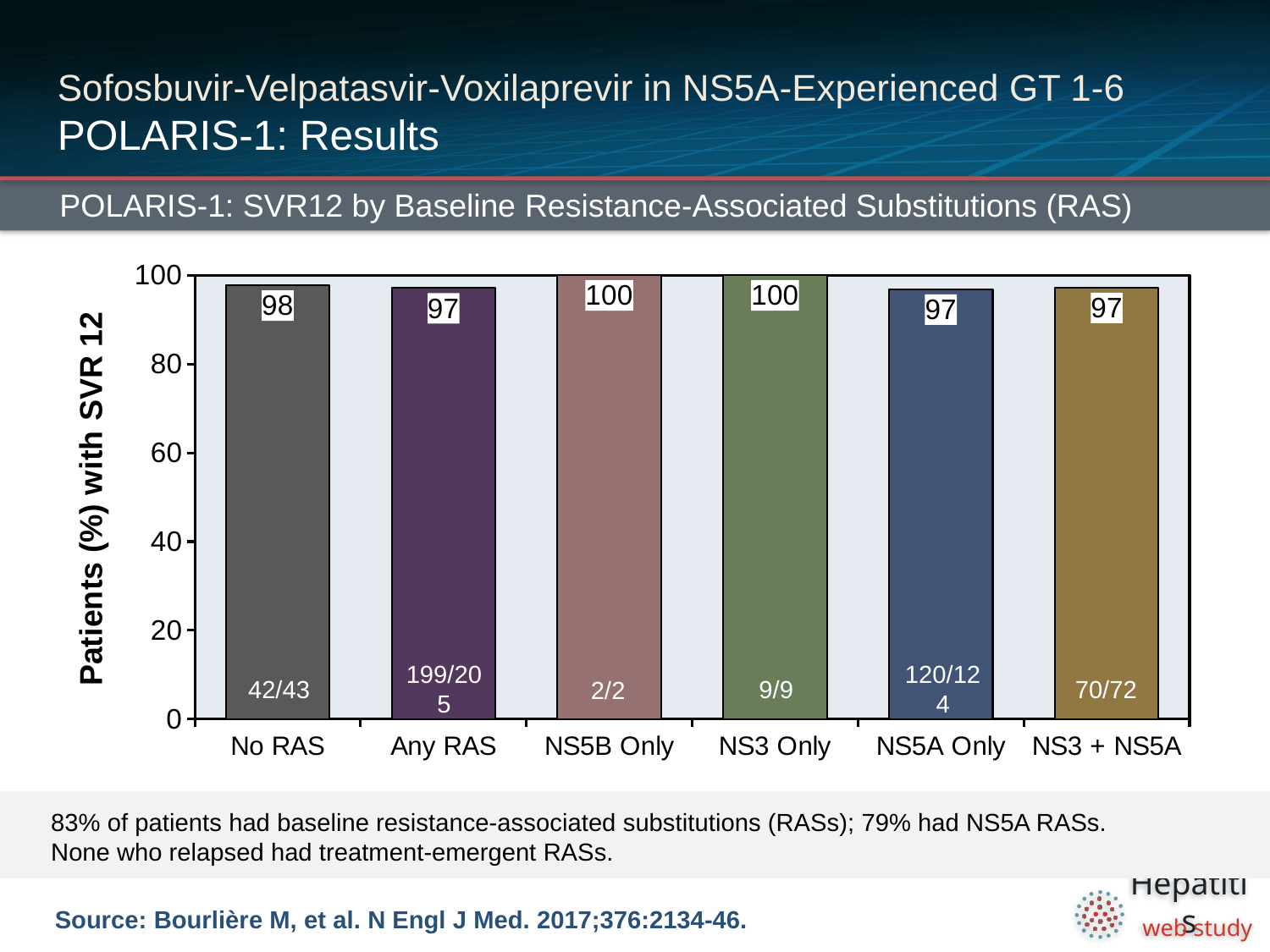
What fraction of patients is shown inside the NS3 Only bar? 9/9 What is the label of the y axis? Patients (%) with SVR 12 What is the SVR12 rate for the Any RAS group? 97 What fraction of patients is shown inside the No RAS bar? 42/43 What is the SVR12 rate for the No RAS group? 98 What type of chart is shown on the slide? Bar chart Which groups have the highest SVR12 rate? NS5B Only and NS3 Only What is the SVR12 rate for the NS3 + NS5A group? 97 Is the SVR12 rate for the No RAS group greater or less than 80? greater What is the difference in SVR12 rate between the NS5B Only group and the NS5A Only group? 3 What is the title of the chart? POLARIS-1: SVR12 by Baseline Resistance-Associated Substitutions (RAS) How many baseline RAS categories are shown on the x axis? 6